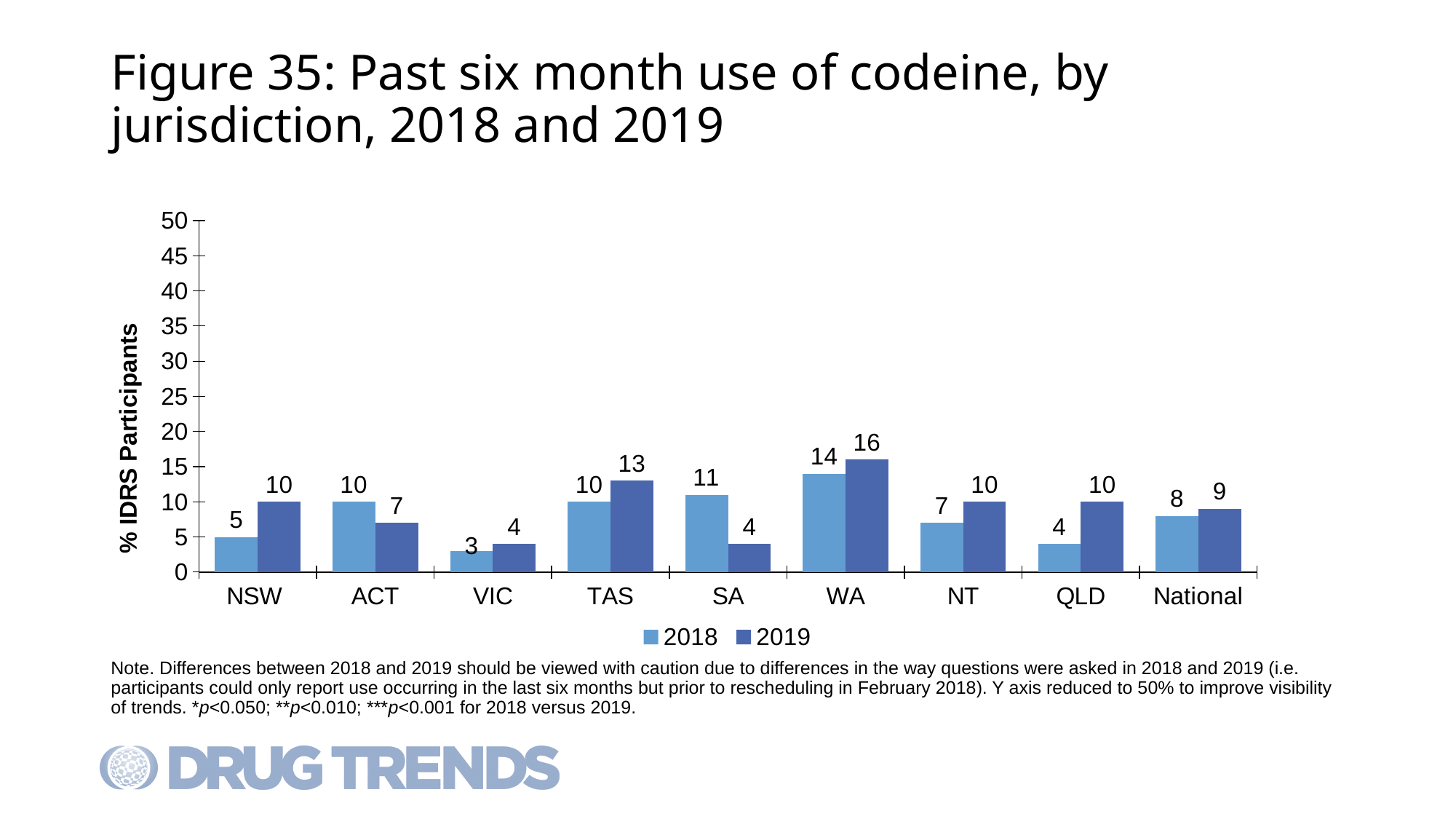
Which is larger for ACT, the 2018 value or the 2019 value? 2018 What is the National value for 2018? 8 How many jurisdiction categories are shown on the x axis? 9 What is the difference between the 2018 and 2019 values for SA? 7 Which jurisdiction has the highest 2019 value? WA Which jurisdiction has the lowest 2018 value? VIC What is the 2018 value for SA? 11 What is the 2019 value for WA? 16 What kind of chart is shown on the slide? Bar chart How many series does the legend list? 2 What is the difference between the 2018 and 2019 values for NSW? 5 What is the label of the y axis? % IDRS Participants